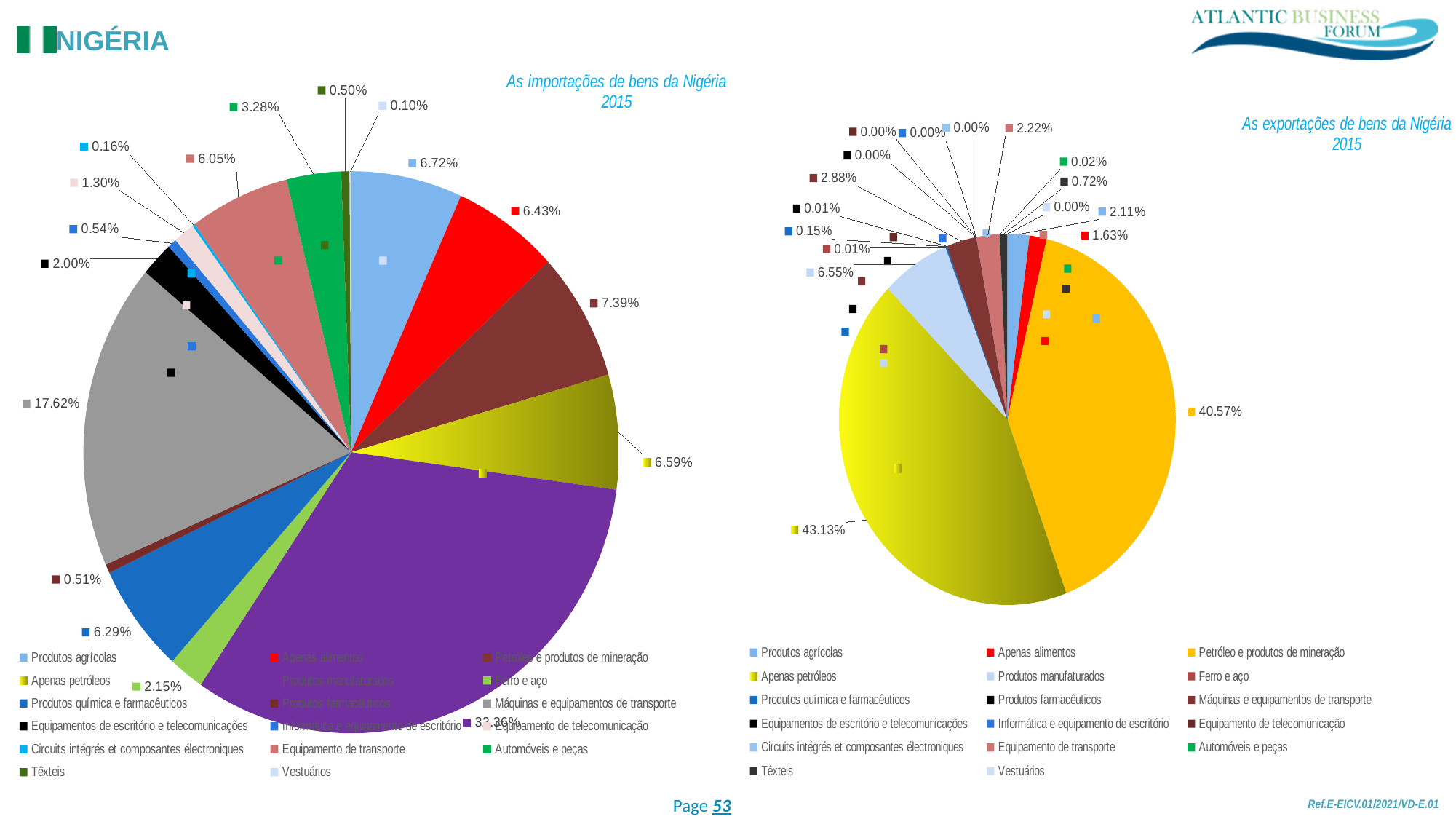
In the chart 'As exportações de bens da Nigéria 2015', which is larger: Apenas petróleos or Petróleo e produtos de mineração? Apenas petróleos In the chart 'As importações de bens da Nigéria 2015', what is the share for Produtos agrícolas? 6.72% How many categories does the legend of the chart 'As importações de bens da Nigéria 2015' list? 17 In the chart 'As importações de bens da Nigéria 2015', what is the share for Petróleo e produtos de mineração? 7.39% In the chart 'As exportações de bens da Nigéria 2015', what is the share for Apenas alimentos? 1.63% In the chart 'As exportações de bens da Nigéria 2015', what is the value of the largest slice? 43.13% In the chart 'As importações de bens da Nigéria 2015', what is the value of the largest slice? 32.36% In the chart 'As importações de bens da Nigéria 2015', what is the share for Máquinas e equipamentos de transporte? 17.62% What kind of chart is used for 'As importações de bens da Nigéria 2015'? Pie chart In the chart 'As exportações de bens da Nigéria 2015', what is the difference between Apenas petróleos (43.13%) and Petróleo e produtos de mineração (40.57%)? 2.56% In the chart 'As exportações de bens da Nigéria 2015', what is the share for Produtos agrícolas? 2.11% In the chart 'As exportações de bens da Nigéria 2015', what is the share for Petróleo e produtos de mineração? 40.57%